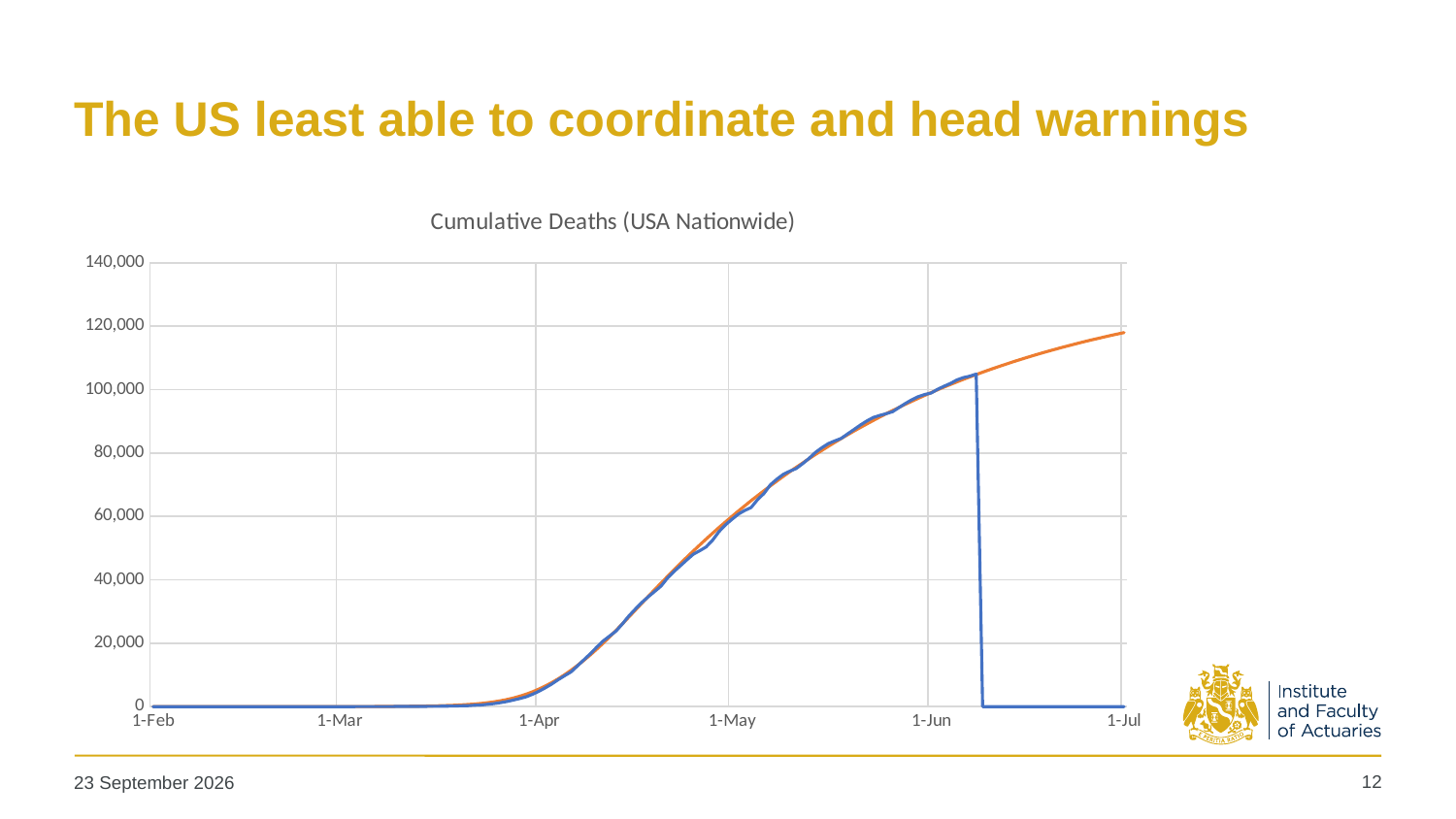
Is the value of the orange line at 1-Jul greater or less than 100,000? greater How many lines are plotted on the chart? 2 Does the orange line rise or fall from 1-Feb to 1-Jul? rise What is the title of the chart? Cumulative Deaths (USA Nationwide) What is the highest value labelled on the y axis? 140,000 What kind of chart is shown on the slide? line chart What value does the blue line show at 1-Jul? 0 Is the value of the orange line at 1-Jun greater or less than 80,000? greater How many date labels are shown on the x axis? 6 Is the value of the orange line at 1-Apr greater or less than 20,000? less Which line is higher at 1-Jul, the orange line or the blue line? orange line